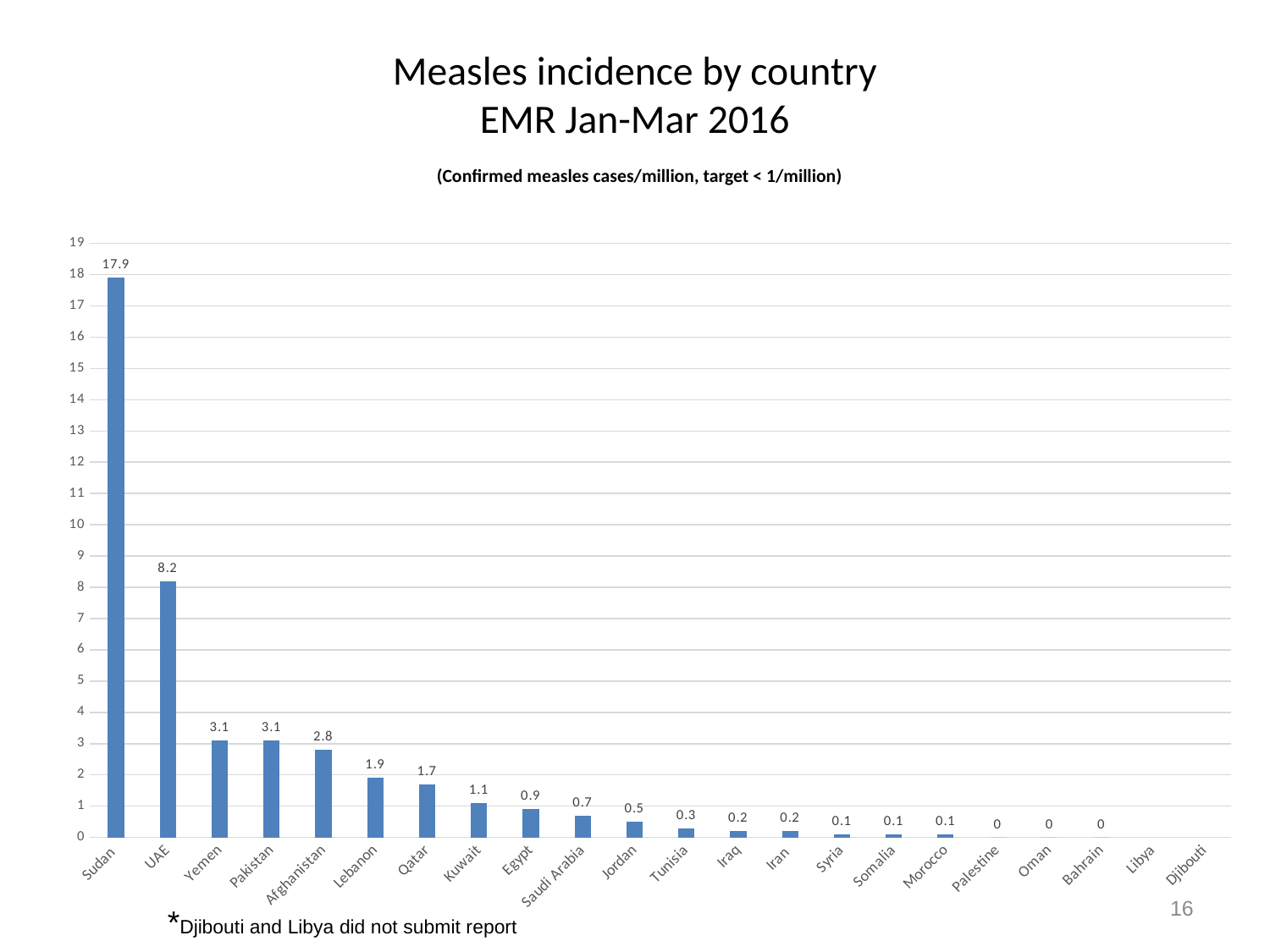
What is the difference between the values for Sudan and UAE? 9.7 What is the title of the chart? Measles incidence by country EMR Jan-Mar 2016 What is the value shown for Afghanistan? 2.8 Which has a larger value, Egypt or Saudi Arabia? Egypt Which country has the highest measles incidence on the chart? Sudan What is the value shown for Kuwait? 1.1 Is the value for UAE greater or less than 10? less What is the difference between the values for Lebanon and Qatar? 0.2 How many countries are listed along the x axis? 22 What is the measles incidence value shown for Sudan? 17.9 What is the value shown for UAE? 8.2 What kind of chart is shown on the slide? Bar chart